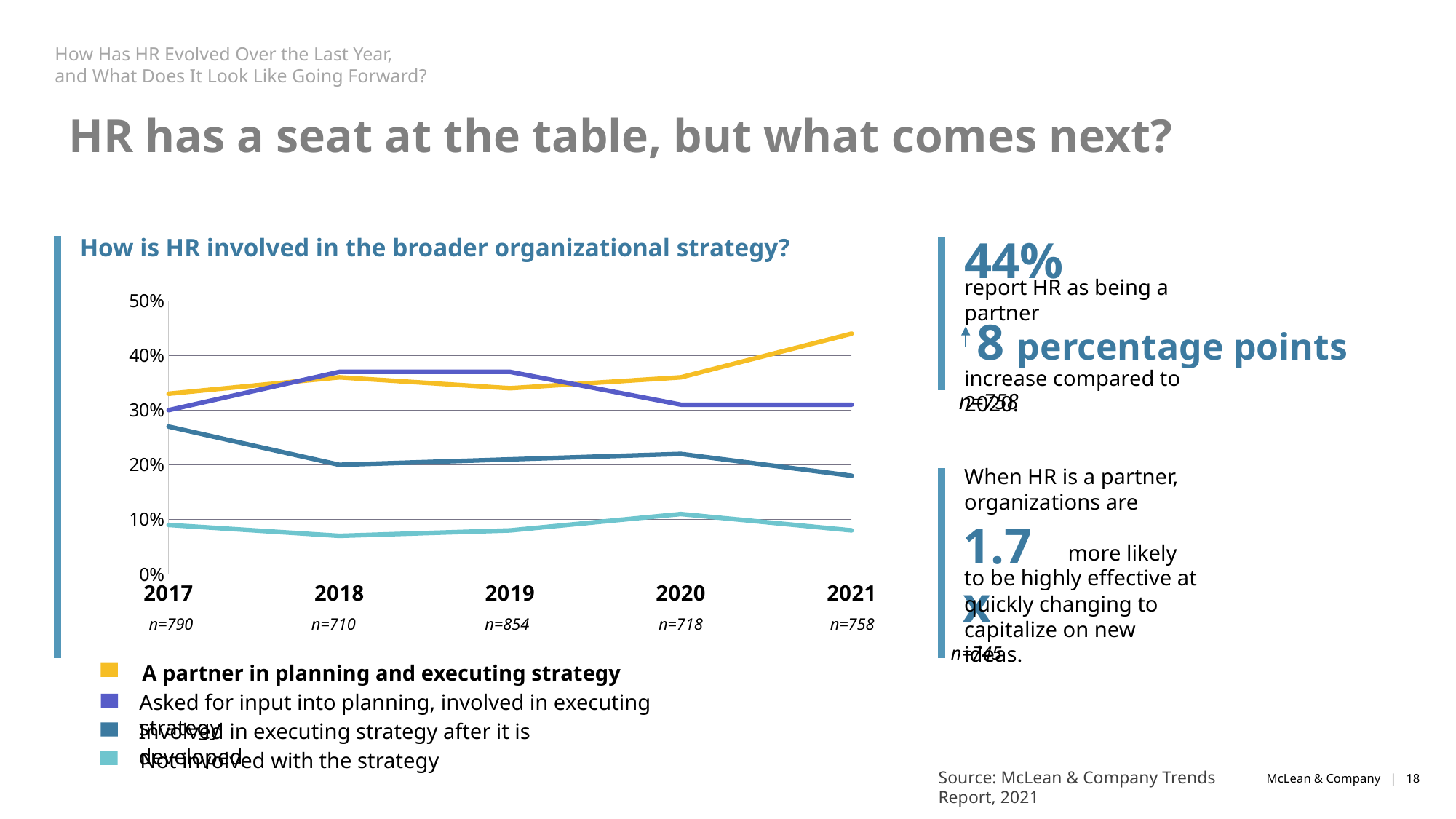
In 2021, which is larger: 'A partner in planning and executing strategy' or 'Asked for input into planning, involved in executing strategy'? A partner in planning and executing strategy What is the title of the chart? How is HR involved in the broader organizational strategy? In which year does the 'A partner in planning and executing strategy' series reach its highest value? 2021 Is the value for 'Not involved with the strategy' in 2018 greater or less than 10%? less How many years are plotted along the x axis of the chart? 5 Which series has the highest value in 2021? A partner in planning and executing strategy Is the value for 'Involved in executing strategy after it is developed' in 2021 greater or less than 20%? less How many series does the chart's legend list? 4 Is the value for 'A partner in planning and executing strategy' in 2021 greater or less than 40%? greater Which series has the lowest value in 2017? Not involved with the strategy What kind of chart is shown on the slide? line chart Does the 'A partner in planning and executing strategy' series rise or fall from 2019 to 2021? rise